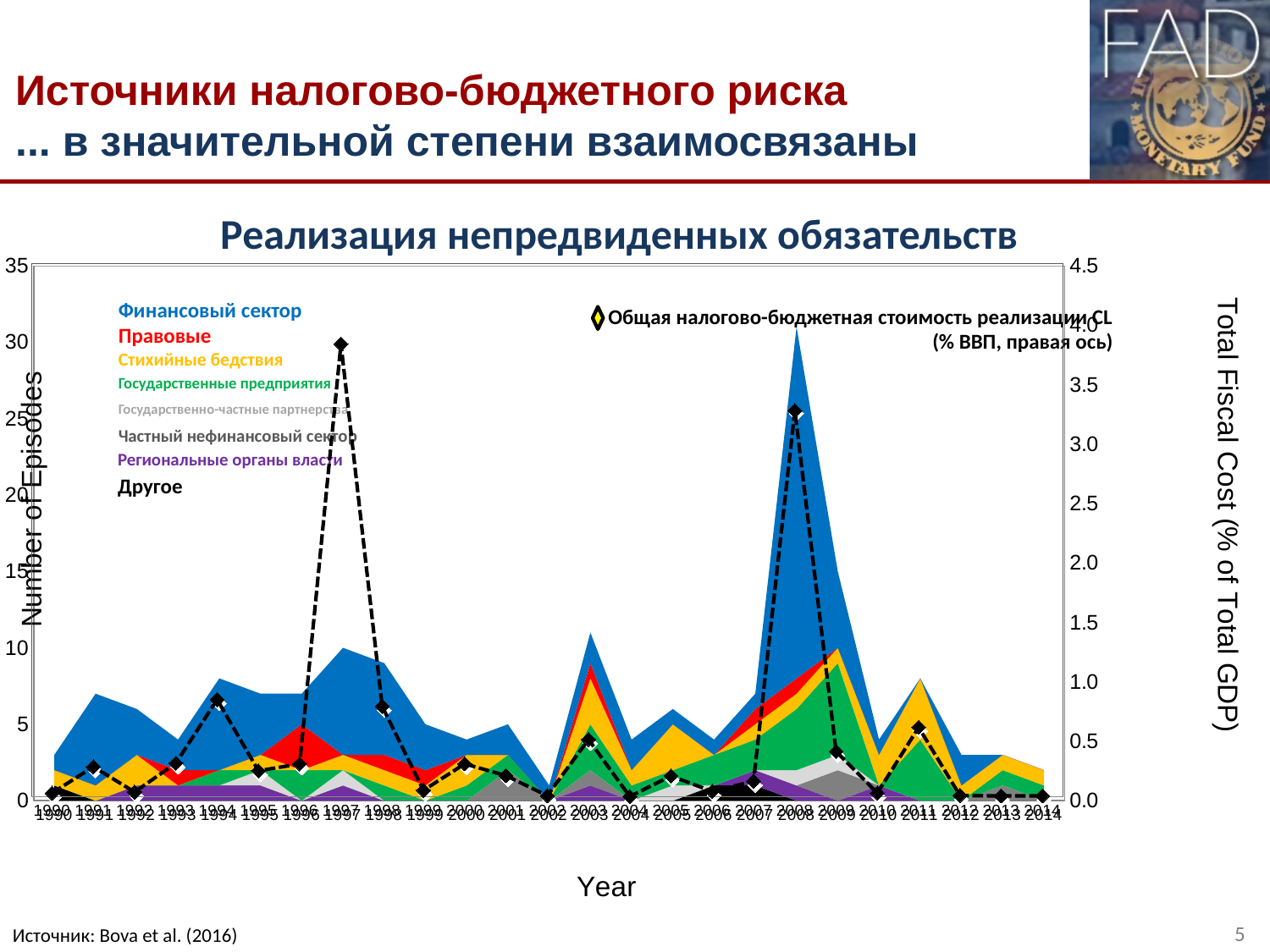
Does the dashed line rise or fall from 2008 to 2010? fall Is the dashed-line value for 1997 greater or less than 3.5 on the right axis? greater Is the dashed-line value for 2008 greater or less than 3.0 on the right axis? greater Is the total number of episodes in 2002 greater or less than 5? less Which year has the larger dashed-line value, 1997 or 2008? 1997 What is the title of the chart? Реализация непредвиденных обязательств What kind of chart is shown on the slide? Stacked area chart with a dashed line overlay In which year does the dashed line (Общая налогово-бюджетная стоимость реализации CL) reach its highest value? 1997 How many categories does the left-hand legend of the chart list? 8 In which year is the total number of episodes (stacked area) highest? 2008 How many years are plotted along the x axis of the chart? 25